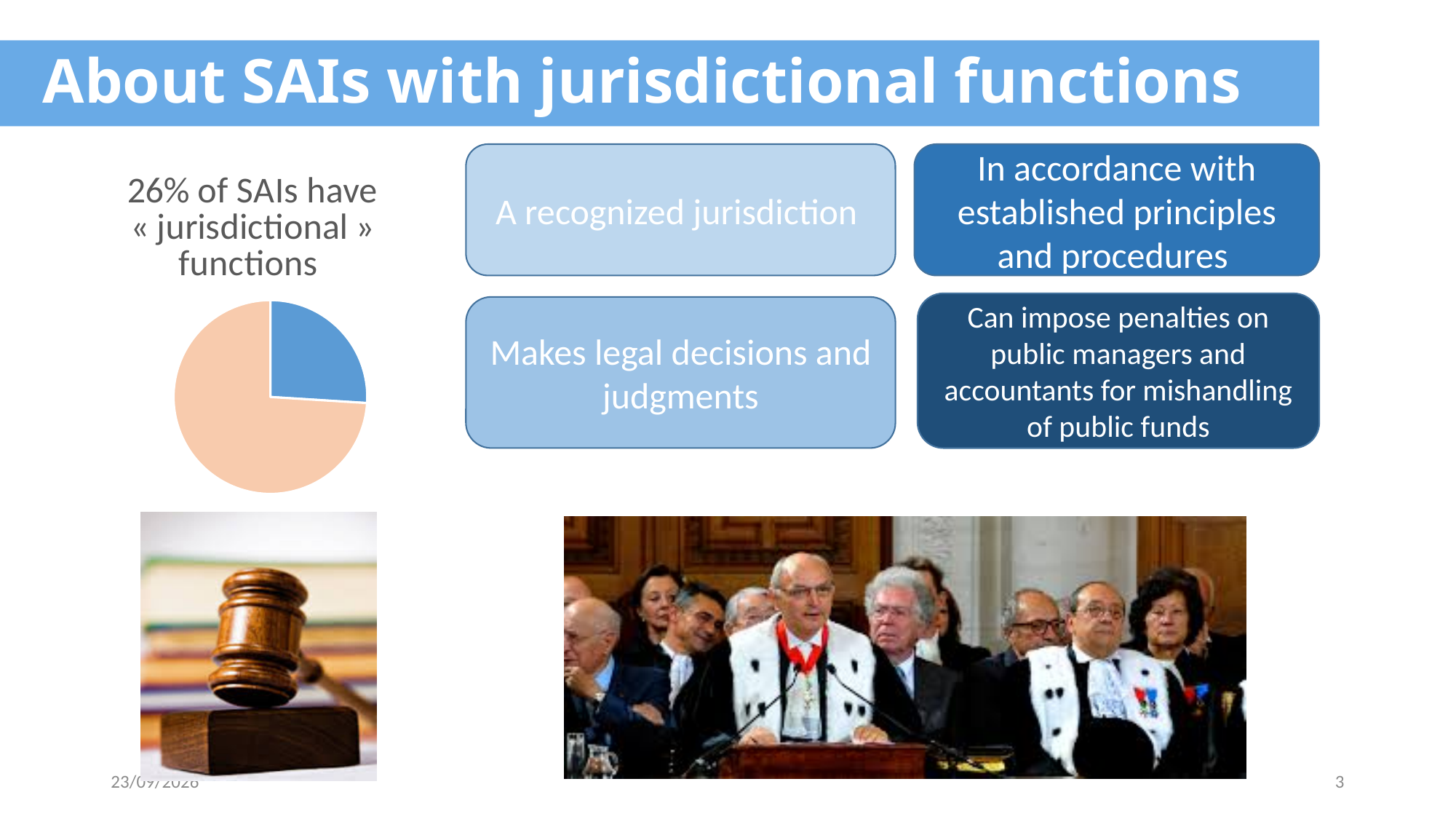
How many slices does the pie chart have? 2 What text accompanies the pie chart as its heading? 26% of SAIs have « jurisdictional » functions According to the slide, what share of SAIs have jurisdictional functions? 26% What kind of chart is shown on the slide? pie chart What colour is the slice representing SAIs with jurisdictional functions? blue Which slice of the pie chart is the smallest? the blue slice (SAIs with jurisdictional functions) Which slice of the pie chart is larger, the blue one or the peach one? the peach one